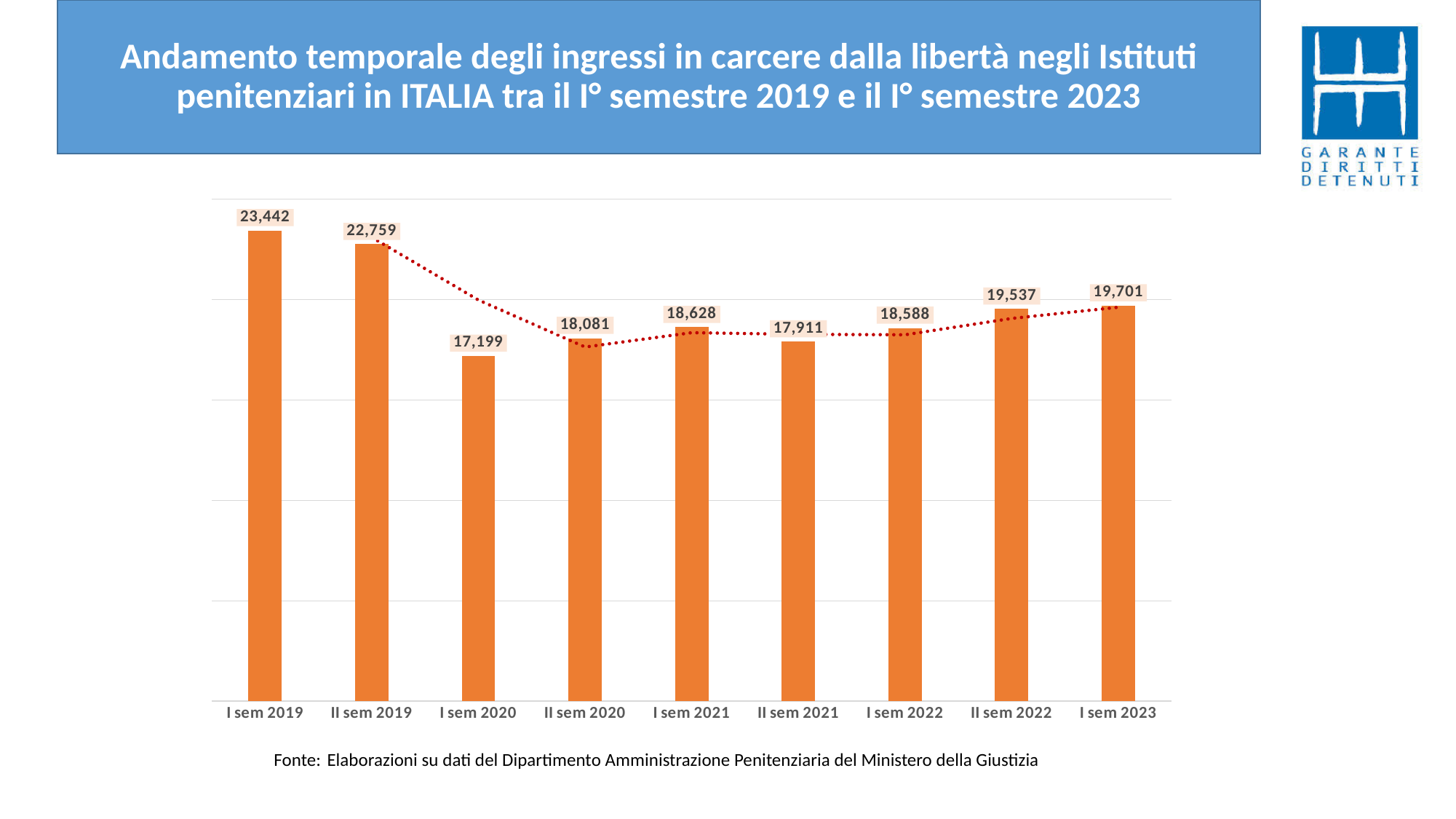
Do the values rise or fall from II sem 2021 to I sem 2023? Rise What is the value for I sem 2019? 23,442 What is the difference between the values for I sem 2019 and I sem 2020? 6,243 What colour are the bars? Orange Which is larger, the value for II sem 2020 or the value for I sem 2022? I sem 2022 What is the difference between the values for I sem 2021 and II sem 2021? 717 Which semester has the lowest value? I sem 2020 How many semesters are shown on the x axis? 9 Which semester has the highest value? I sem 2019 What is the value for I sem 2020? 17,199 What kind of chart is this? Bar chart What is the value for II sem 2022? 19,537